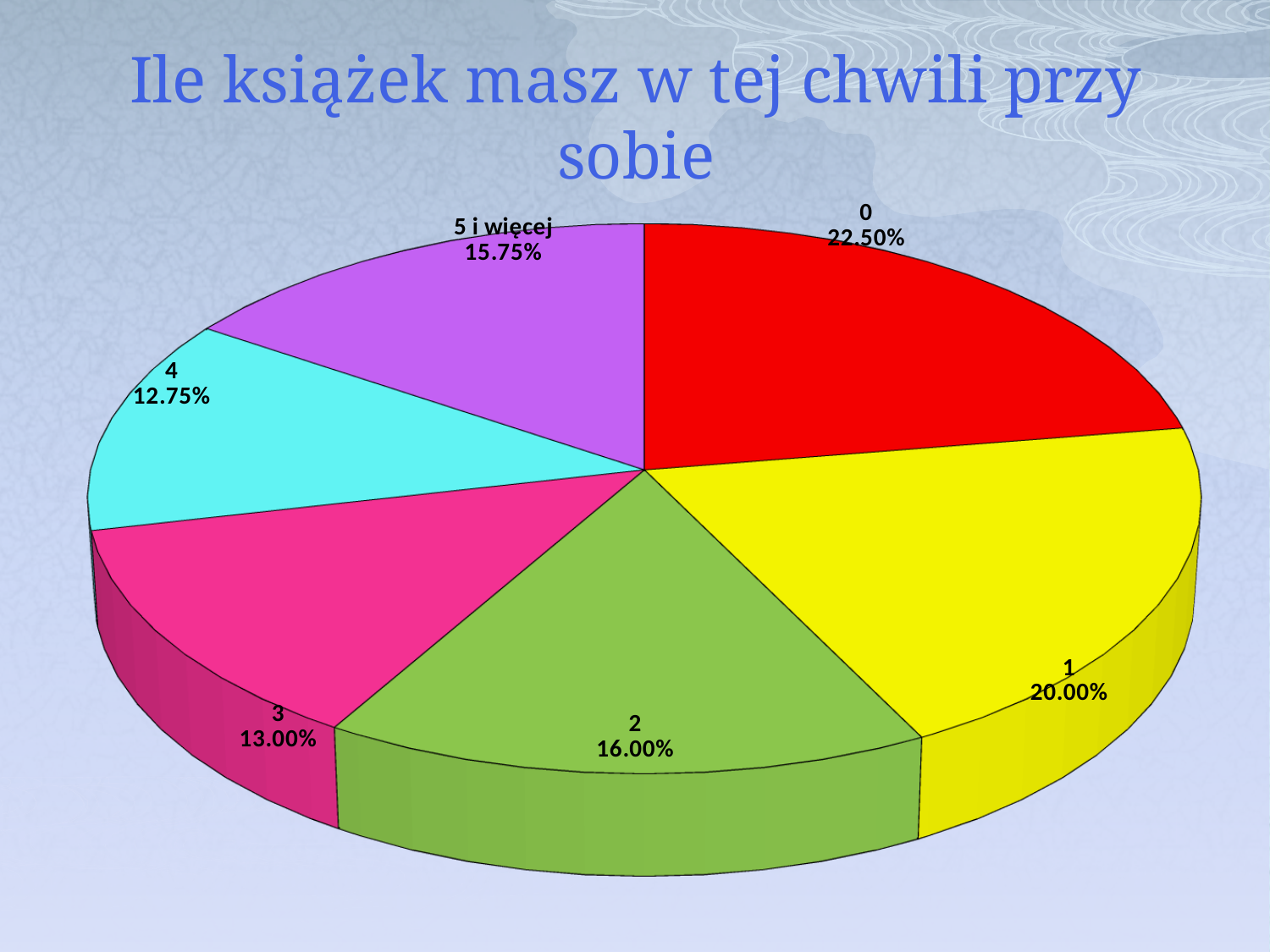
What is the difference between the shares for "0" and "1"? 2.50% Which is larger, the share for "2" or the share for "5 i więcej"? 2 Which category has the largest share of the pie? 0 Which category has the smallest share of the pie? 4 How many slices does the pie chart have? 6 What kind of chart is shown on the slide? pie chart What colour is the slice for category "1"? yellow What is the value labelled on the "3" slice? 13.00% What is the title of the chart? Ile książek masz w tej chwili przy sobie What share of the pie does the "0" slice represent? 22.50% What percentage is shown for the "5 i więcej" slice? 15.75% What is the difference between the shares for "2" and "4"? 3.25%